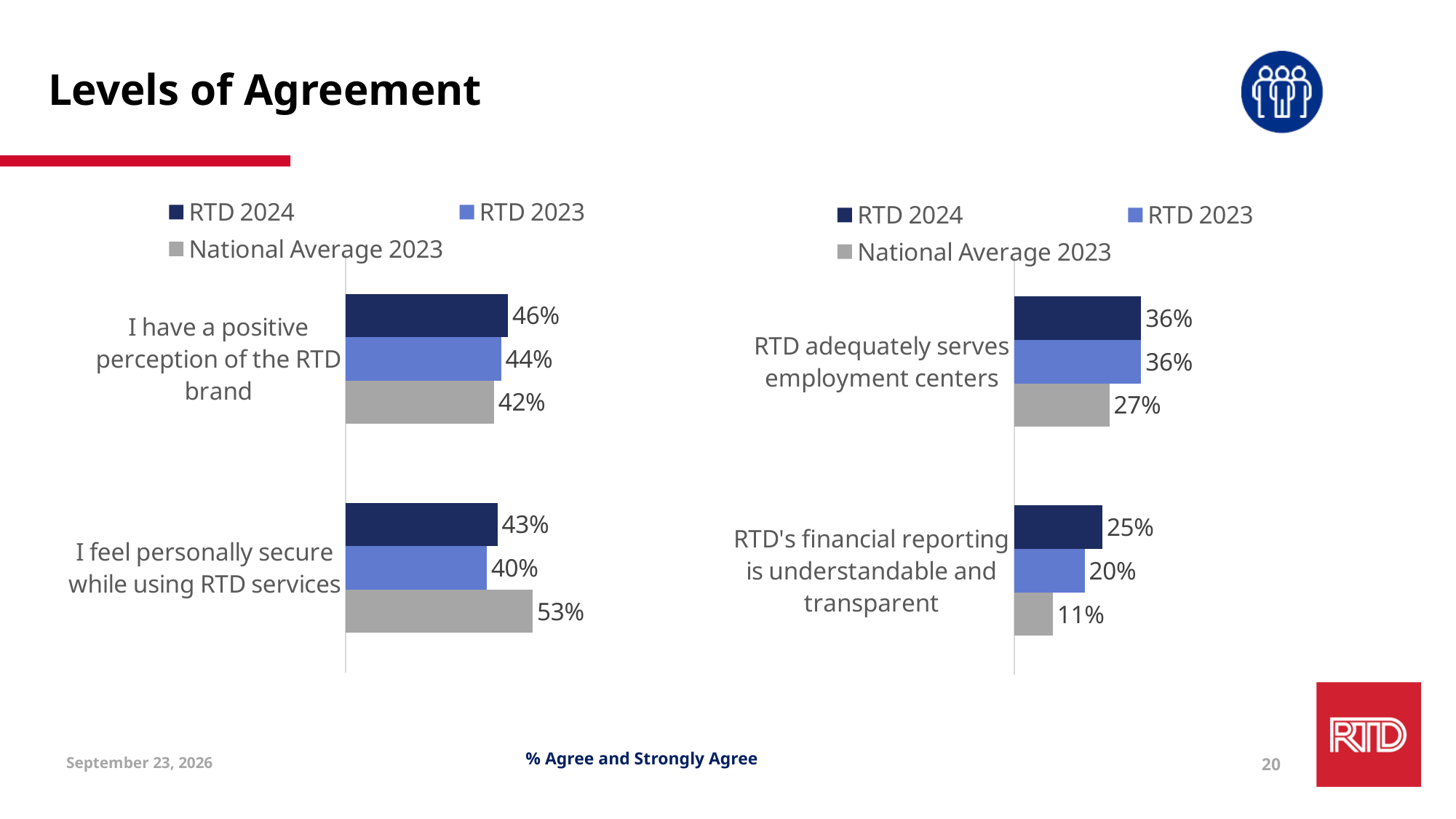
In the left chart, is the RTD 2024 value for "I have a positive perception of the RTD brand" larger or smaller than the National Average 2023 value? larger In the right chart, what is the difference between the RTD 2024 and National Average 2023 values for "RTD's financial reporting is understandable and transparent"? 14% In the right chart, which series has the lowest value for "RTD's financial reporting is understandable and transparent"? National Average 2023 In the left chart, what is the difference between the RTD 2024 and RTD 2023 values for "I feel personally secure while using RTD services"? 3% In the right chart, what is the RTD 2023 value for "RTD's financial reporting is understandable and transparent"? 20% How many categories are shown in the left chart? 2 In the left chart, what is the RTD 2024 value for "I have a positive perception of the RTD brand"? 46% In the right chart, what is the National Average 2023 value for "RTD adequately serves employment centers"? 27% How many series does the legend of the right chart list? 3 In the left chart, which series has the highest value for "I feel personally secure while using RTD services"? National Average 2023 In the left chart, what is the National Average 2023 value for "I feel personally secure while using RTD services"? 53% What kind of chart is the right chart? bar chart